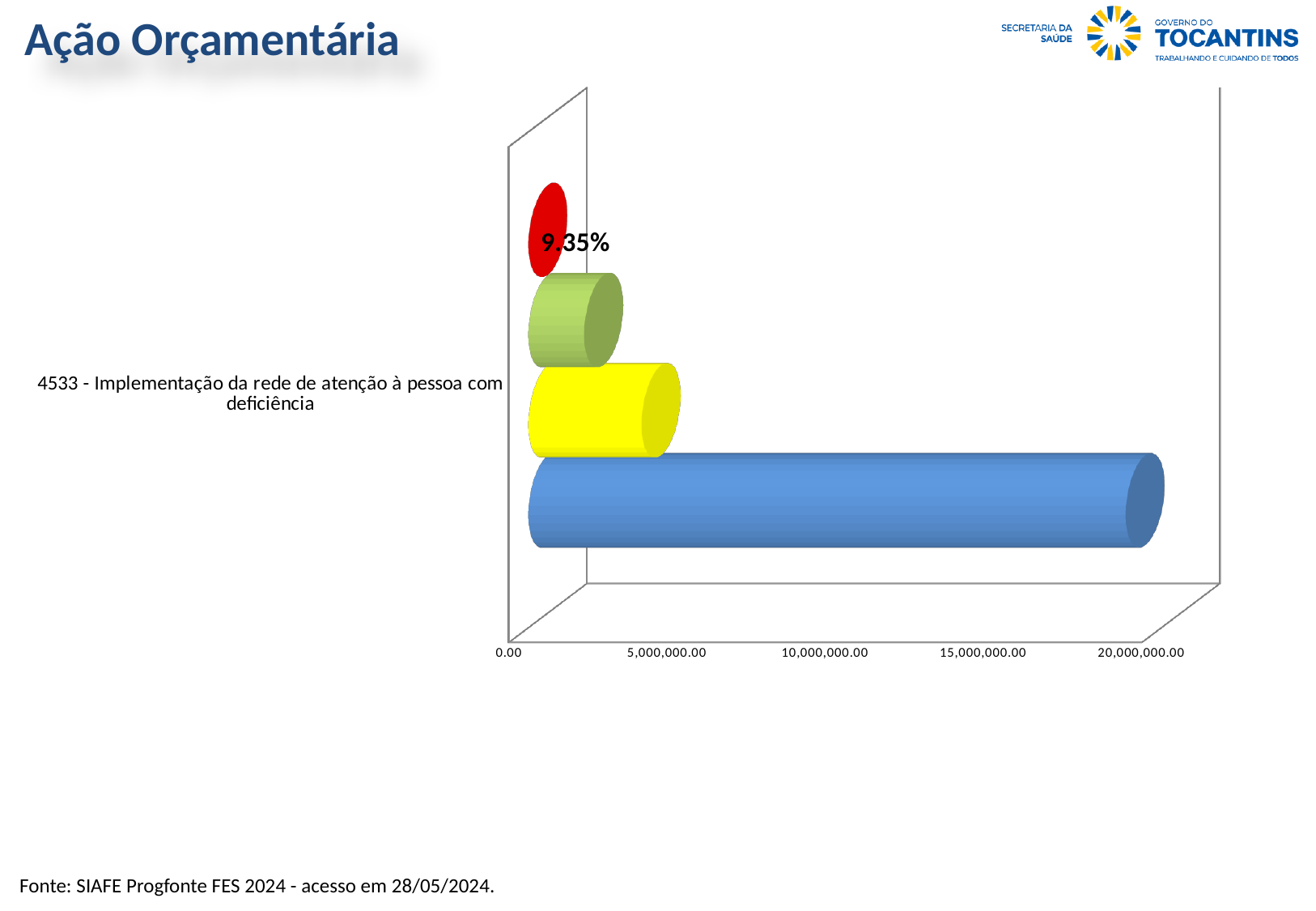
Which coloured bar is the shortest on the chart? red Which coloured bar is the longest on the chart? blue Which is larger, the blue bar or the yellow bar? blue bar What kind of chart is shown on the slide? bar chart How many categories are shown on the chart's vertical axis? 1 Is the value of the blue bar greater or less than 15,000,000.00? greater How many bars are plotted for the category on the chart? 4 What data label is printed on the red bar? 9.35% What is the category label shown on the chart? 4533 - Implementação da rede de atenção à pessoa com deficiência What is the highest tick value shown on the horizontal axis? 20,000,000.00 Is the value of the green bar greater or less than 5,000,000.00? less